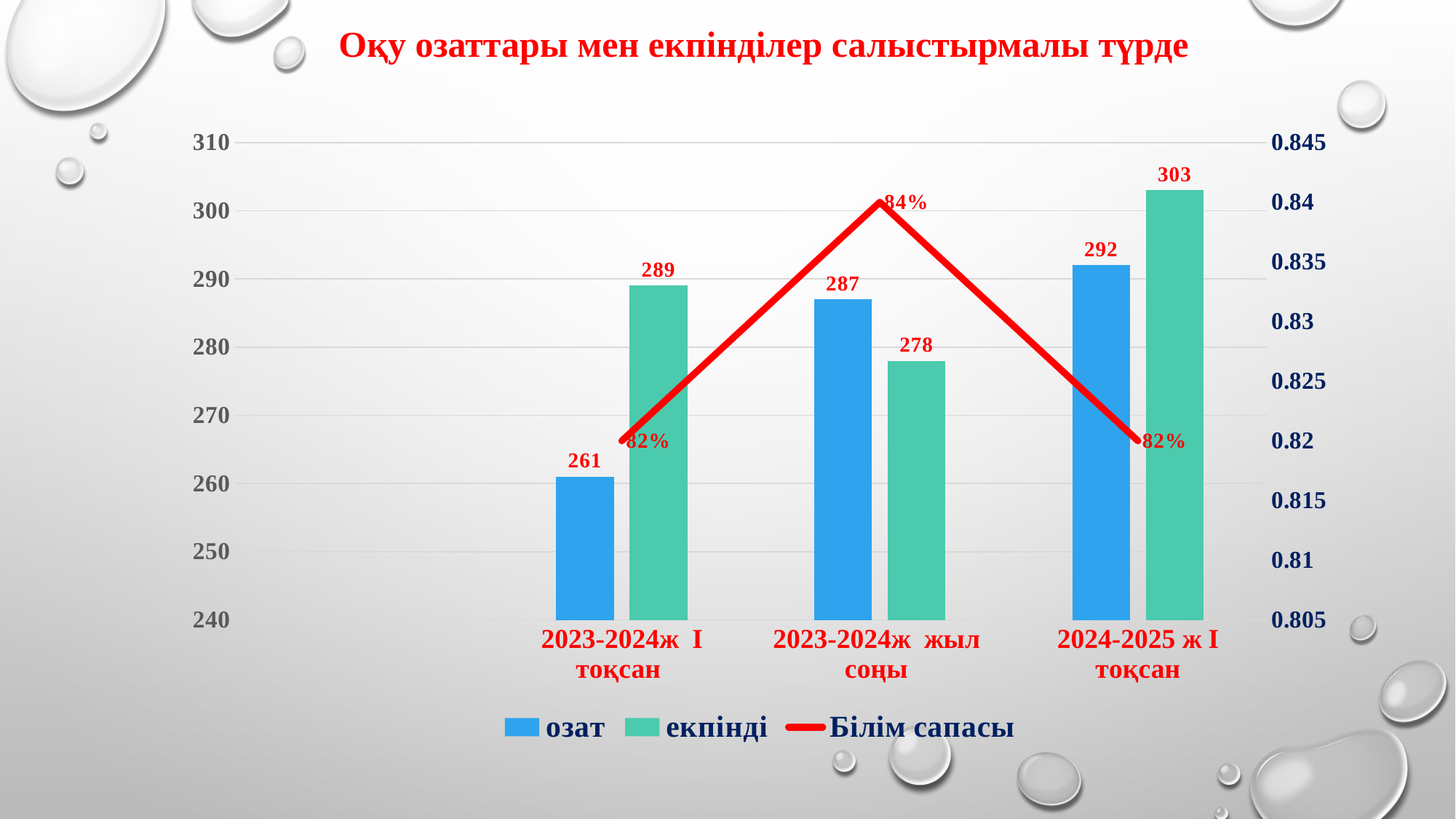
What is the Білім сапасы value for 2023-2024ж жыл соңы? 84% Do the озат values rise or fall from 2023-2024ж I тоқсан to 2024-2025 ж I тоқсан? rise Which category has the highest екпінді value? 2024-2025 ж I тоқсан How many categories are shown on the x axis? 3 Which category has the lowest озат value? 2023-2024ж I тоқсан How many series does the legend list? 3 Which is larger for 2023-2024ж жыл соңы, озат or екпінді? озат What is the difference between екпінді and озат for 2023-2024ж I тоқсан? 28 What kind of chart is this? Combined bar and line chart What is the value of екпінді for 2024-2025 ж I тоқсан? 303 What is the value of озат for 2023-2024ж I тоқсан? 261 What is the value of озат for 2023-2024ж жыл соңы? 287